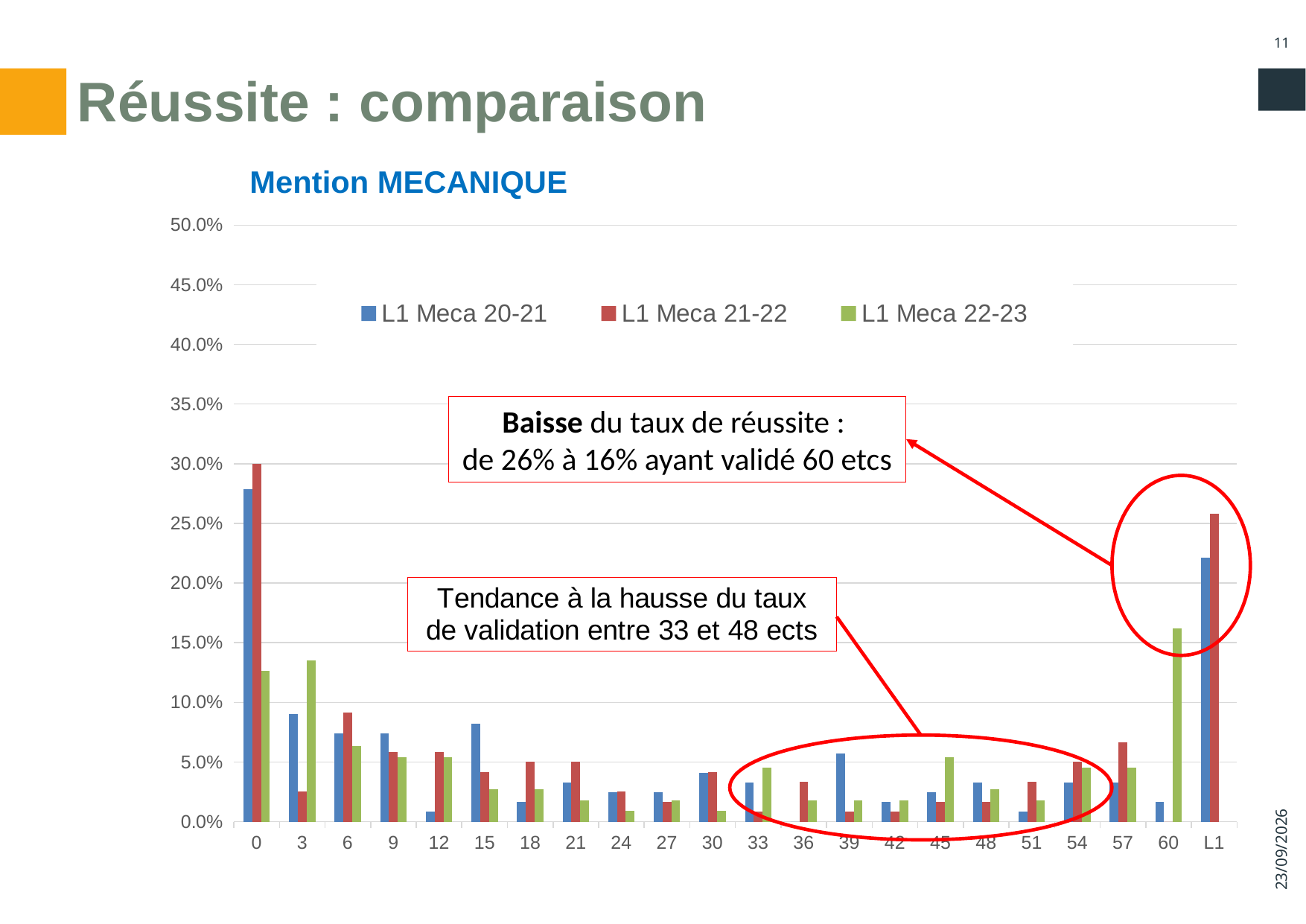
For the series L1 Meca 22-23, which category has the highest value? 60 At category 45, which is larger: L1 Meca 20-21 or L1 Meca 22-23? L1 Meca 22-23 Is the value for L1 Meca 20-21 at category 0 greater or less than 25.0%? greater How many series does the legend list? 3 At category 15, which is larger: L1 Meca 20-21 or L1 Meca 21-22? L1 Meca 20-21 What is the title of the chart? Mention MECANIQUE Is the value for L1 Meca 22-23 at category 60 greater or less than 20.0%? less Is the value for L1 Meca 22-23 at category 3 greater or less than 10.0%? greater Which colour represents the series L1 Meca 22-23? green How many categories are shown on the x axis? 22 Which series has the highest value at category L1? L1 Meca 21-22 What kind of chart is shown on the slide? bar chart